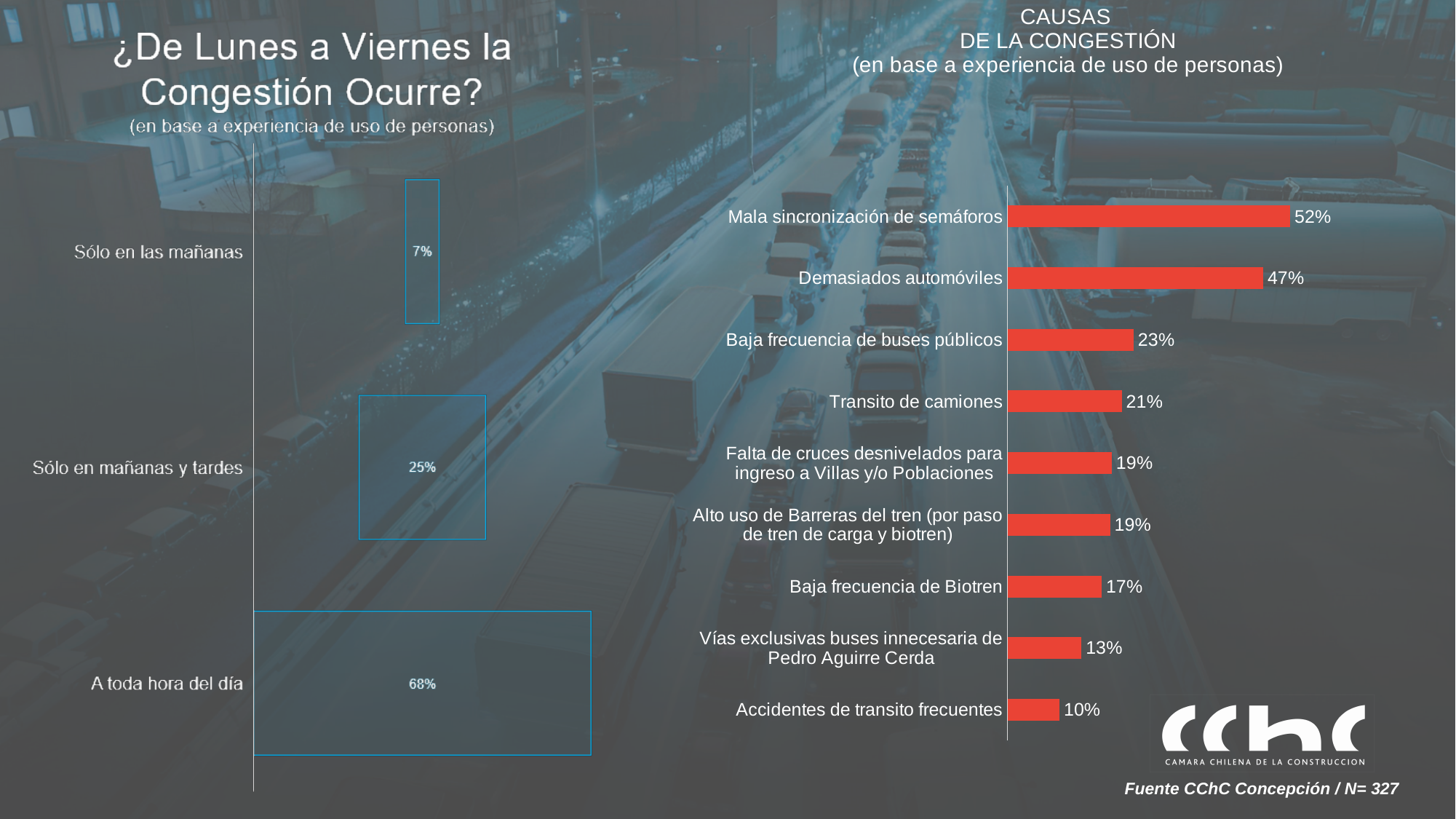
In the chart titled '¿De Lunes a Viernes la Congestión Ocurre?', how many categories are shown? 3 In the chart titled 'CAUSAS DE LA CONGESTIÓN', which is larger: 'Baja frecuencia de buses públicos' or 'Transito de camiones'? Baja frecuencia de buses públicos In the chart titled 'CAUSAS DE LA CONGESTIÓN', how many causes are listed? 9 In the chart titled 'CAUSAS DE LA CONGESTIÓN', what is the difference between 'Mala sincronización de semáforos' and 'Demasiados automóviles'? 5% In the chart titled '¿De Lunes a Viernes la Congestión Ocurre?', what is the difference between 'A toda hora del día' and 'Sólo en mañanas y tardes'? 43% In the chart titled 'CAUSAS DE LA CONGESTIÓN', which cause has the lowest value? Accidentes de transito frecuentes In the chart titled 'CAUSAS DE LA CONGESTIÓN', which cause has the highest value? Mala sincronización de semáforos In the chart titled 'CAUSAS DE LA CONGESTIÓN', what is the value for 'Demasiados automóviles'? 47% In the chart titled 'CAUSAS DE LA CONGESTIÓN', what is the value for 'Baja frecuencia de Biotren'? 17% In the chart titled '¿De Lunes a Viernes la Congestión Ocurre?', which category has the lowest value? Sólo en las mañanas In the chart titled '¿De Lunes a Viernes la Congestión Ocurre?', what is the value for 'Sólo en las mañanas'? 7% In the chart titled '¿De Lunes a Viernes la Congestión Ocurre?', what is the value for 'A toda hora del día'? 68%